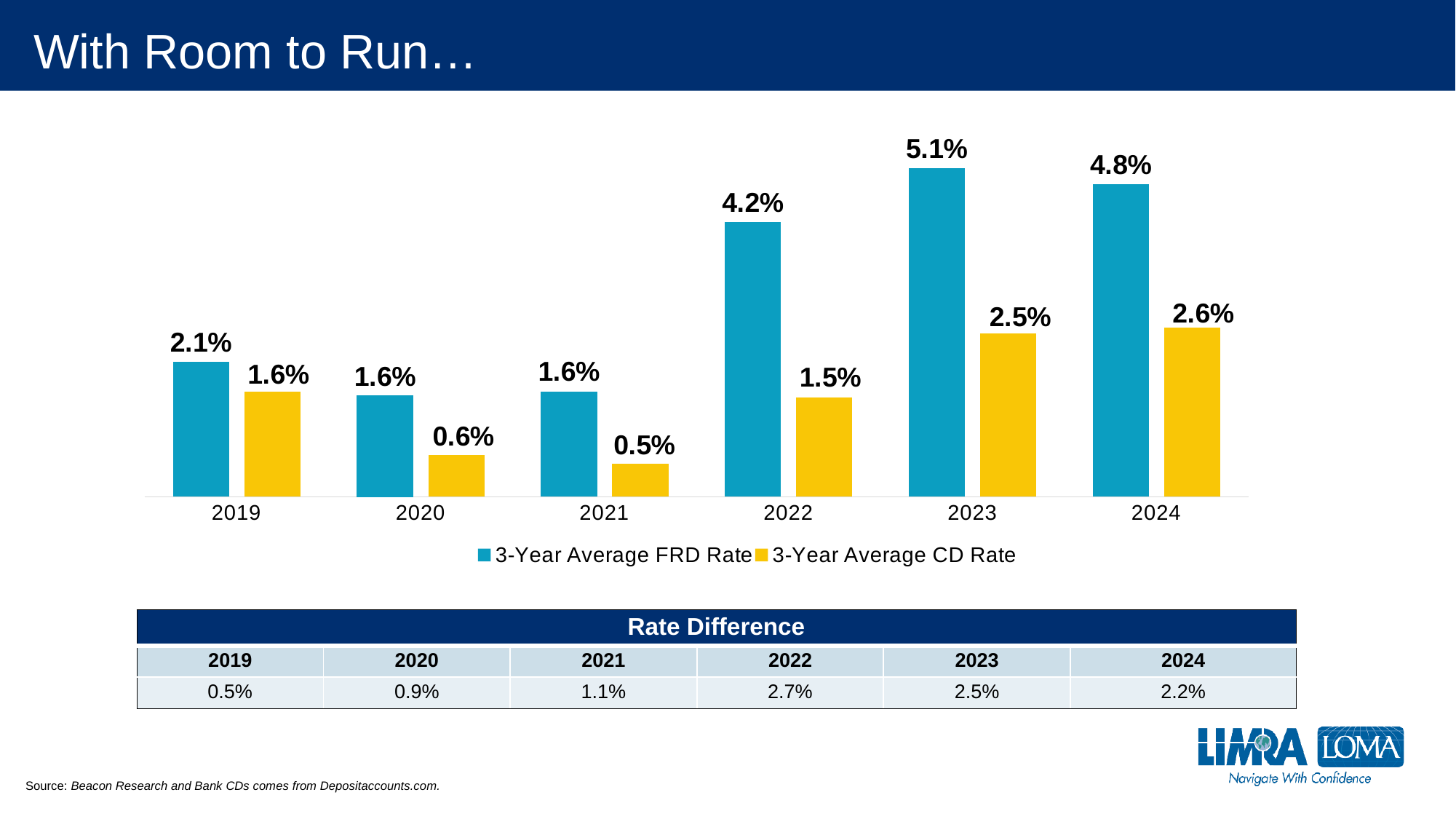
What kind of chart is shown on the slide? Bar chart Which is larger in 2019: the 3-Year Average FRD Rate or the 3-Year Average CD Rate? 3-Year Average FRD Rate Which year has the highest 3-Year Average FRD Rate? 2023 What is the 3-Year Average CD Rate for 2024? 2.6% What is the difference between the 3-Year Average FRD Rate and the 3-Year Average CD Rate in 2022? 2.7% How many years are shown on the x axis of the chart? 6 What colour are the bars for the 3-Year Average CD Rate? Yellow What is the 3-Year Average CD Rate for 2021? 0.5% What is the 3-Year Average FRD Rate for 2023? 5.1% Does the 3-Year Average FRD Rate rise or fall from 2021 to 2023? Rise How many series does the chart's legend list? 2 Which year has the lowest 3-Year Average CD Rate? 2021